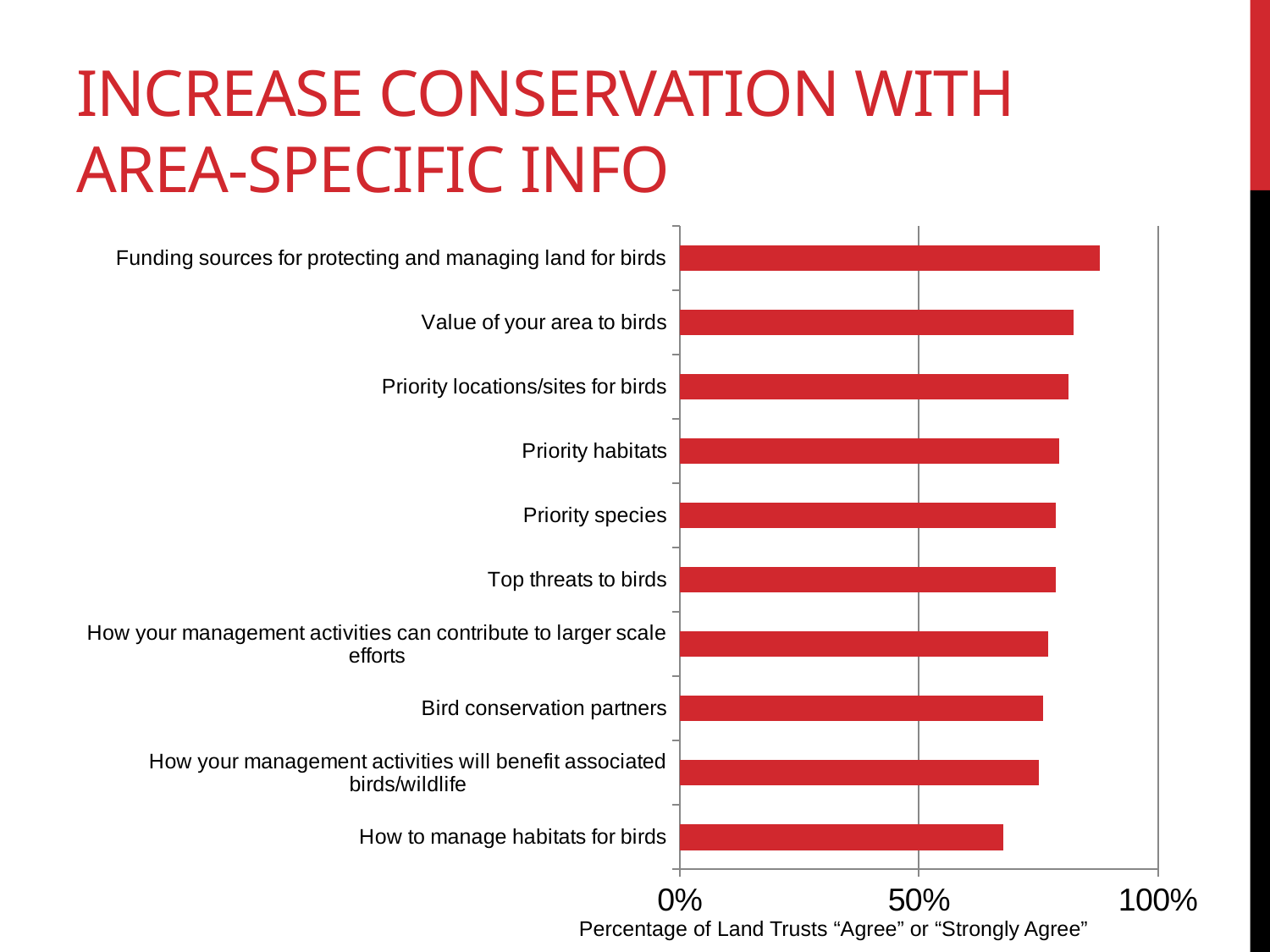
What is the label of the horizontal axis of the chart? Percentage of Land Trusts "Agree" or "Strongly Agree" Which category has the lowest value in the chart? How to manage habitats for birds Is the value for "Funding sources for protecting and managing land for birds" greater or less than 100%? less Is the value for "Priority species" greater or less than 50%? greater Are all the bars in the chart above 50%? Yes Which category has the highest value in the chart? Funding sources for protecting and managing land for birds What kind of chart is shown on the slide? bar chart Which is larger: the value for "Value of your area to birds" or the value for "How to manage habitats for birds"? Value of your area to birds How many categories are plotted in the chart? 10 What colour are the bars in the chart? Red Which is larger: the value for "Funding sources for protecting and managing land for birds" or the value for "Bird conservation partners"? Funding sources for protecting and managing land for birds